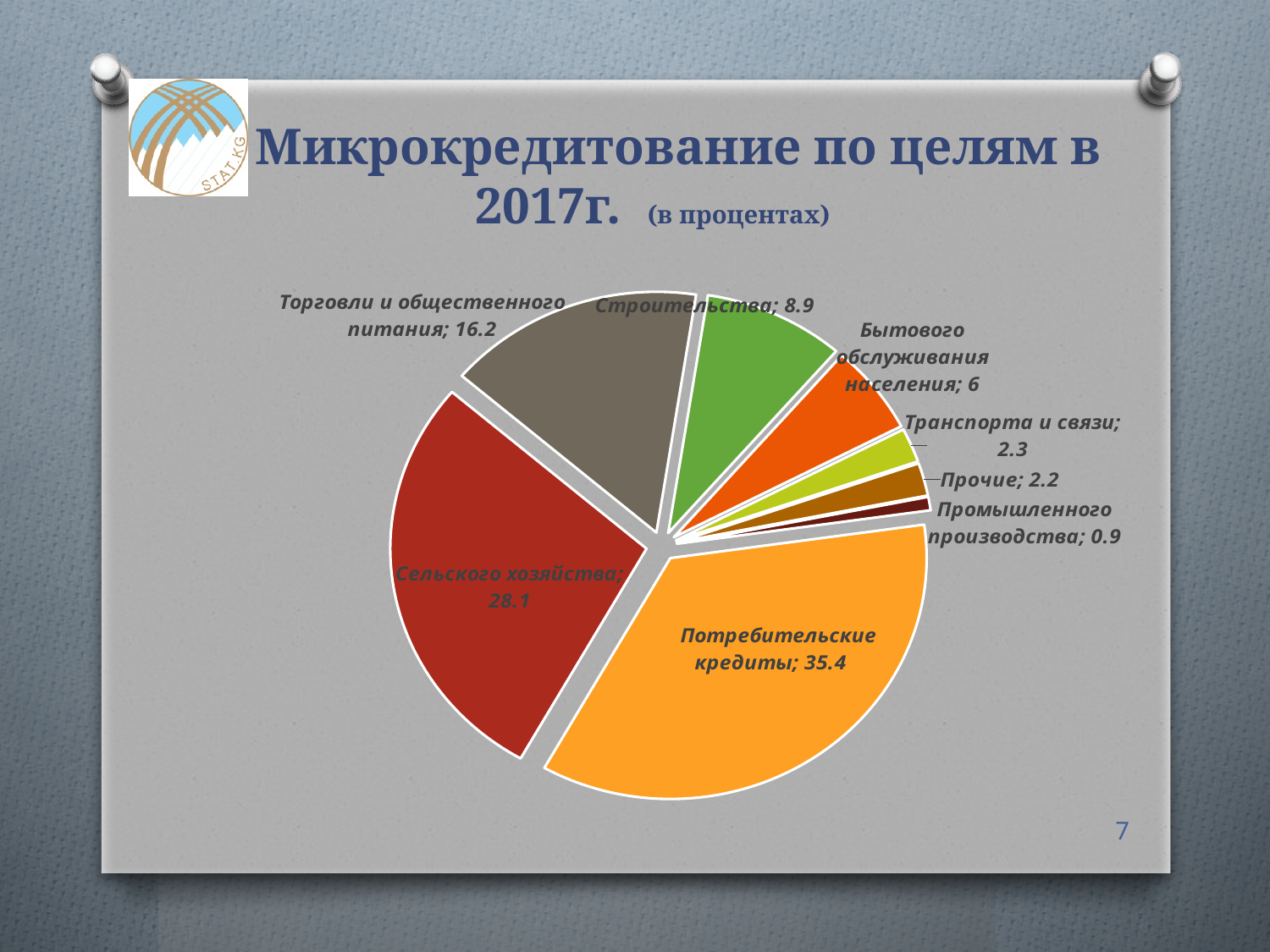
Which is larger, the value for Строительства or the value for Бытового обслуживания населения? Строительства Which category has the largest share of the pie? Потребительские кредиты How many categories are shown in the pie chart? 8 Which category has the smallest share of the pie? Промышленного производства What is the value for Бытового обслуживания населения? 6 What kind of chart is shown on the slide? Pie chart What is the title of the chart on the slide? Микрокредитование по целям в 2017г. (в процентах) What is the value for Торговли и общественного питания? 16.2 What is the difference between the values for Транспорта и связи and Прочие? 0.1 What is the difference between the values for Потребительские кредиты and Сельского хозяйства? 7.3 What is the value for Сельского хозяйства? 28.1 What is the value for Потребительские кредиты? 35.4